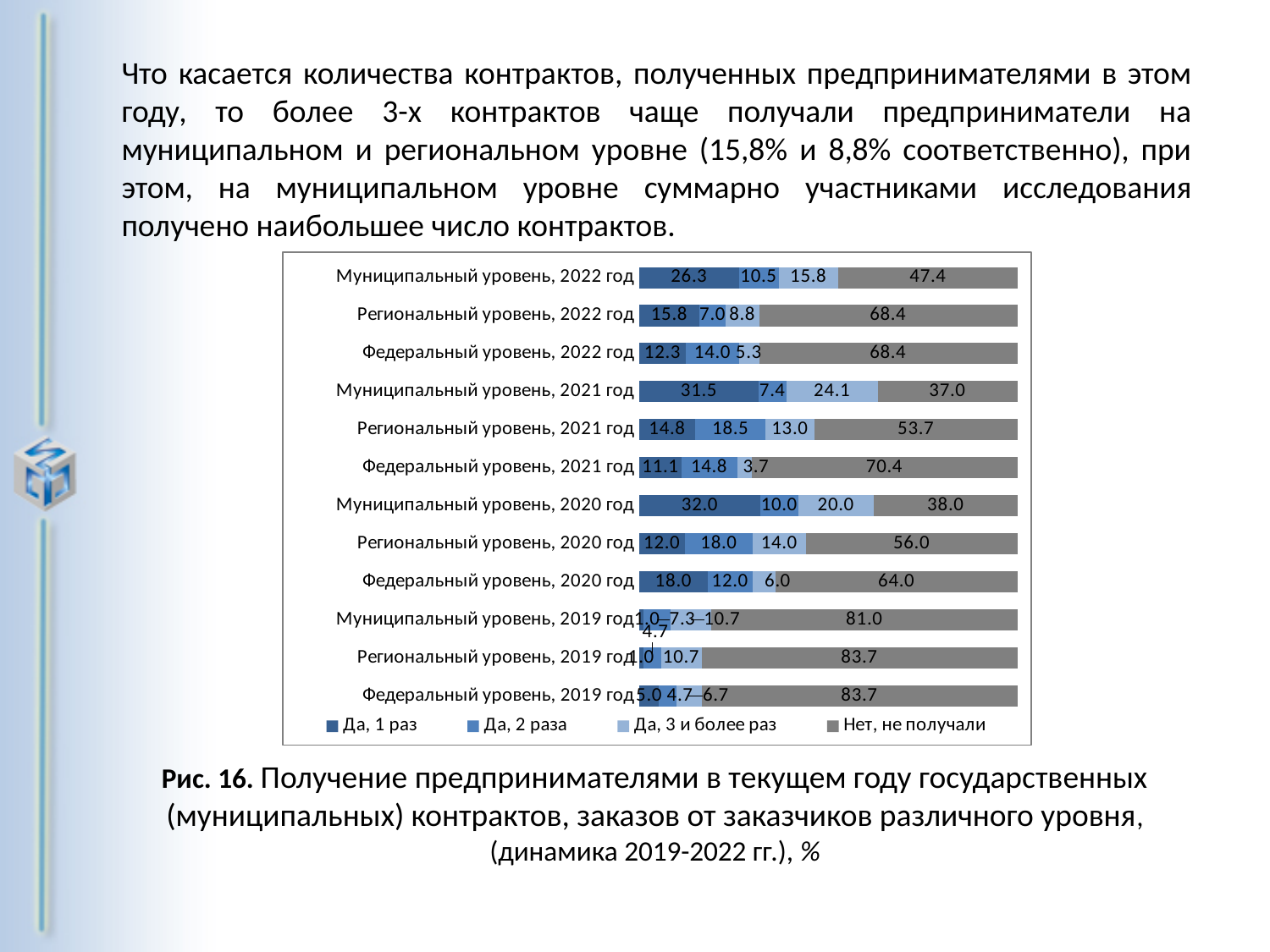
What is the value of "Нет, не получали" for "Муниципальный уровень, 2021 год"? 37.0 What is the difference between the "Нет, не получали" values for "Региональный уровень, 2022 год" and "Муниципальный уровень, 2022 год"? 21.0 What is the total of the stacked bar for "Федеральный уровень, 2020 год"? 100.0 Which has the larger "Да, 2 раза" value: "Региональный уровень, 2021 год" or "Федеральный уровень, 2021 год"? Региональный уровень, 2021 год What is the last entry in the chart's legend? Нет, не получали What is the value of "Да, 3 и более раз" for "Муниципальный уровень, 2022 год"? 15.8 How many categories (bars) are shown in the chart? 12 How many series does the legend of the chart list? 4 Which category has the lowest value for "Нет, не получали"? Муниципальный уровень, 2021 год What kind of chart is shown on the slide? Stacked bar chart Which category has the highest value for "Да, 1 раз"? Муниципальный уровень, 2020 год What is the value of "Да, 2 раза" for "Федеральный уровень, 2022 год"? 14.0